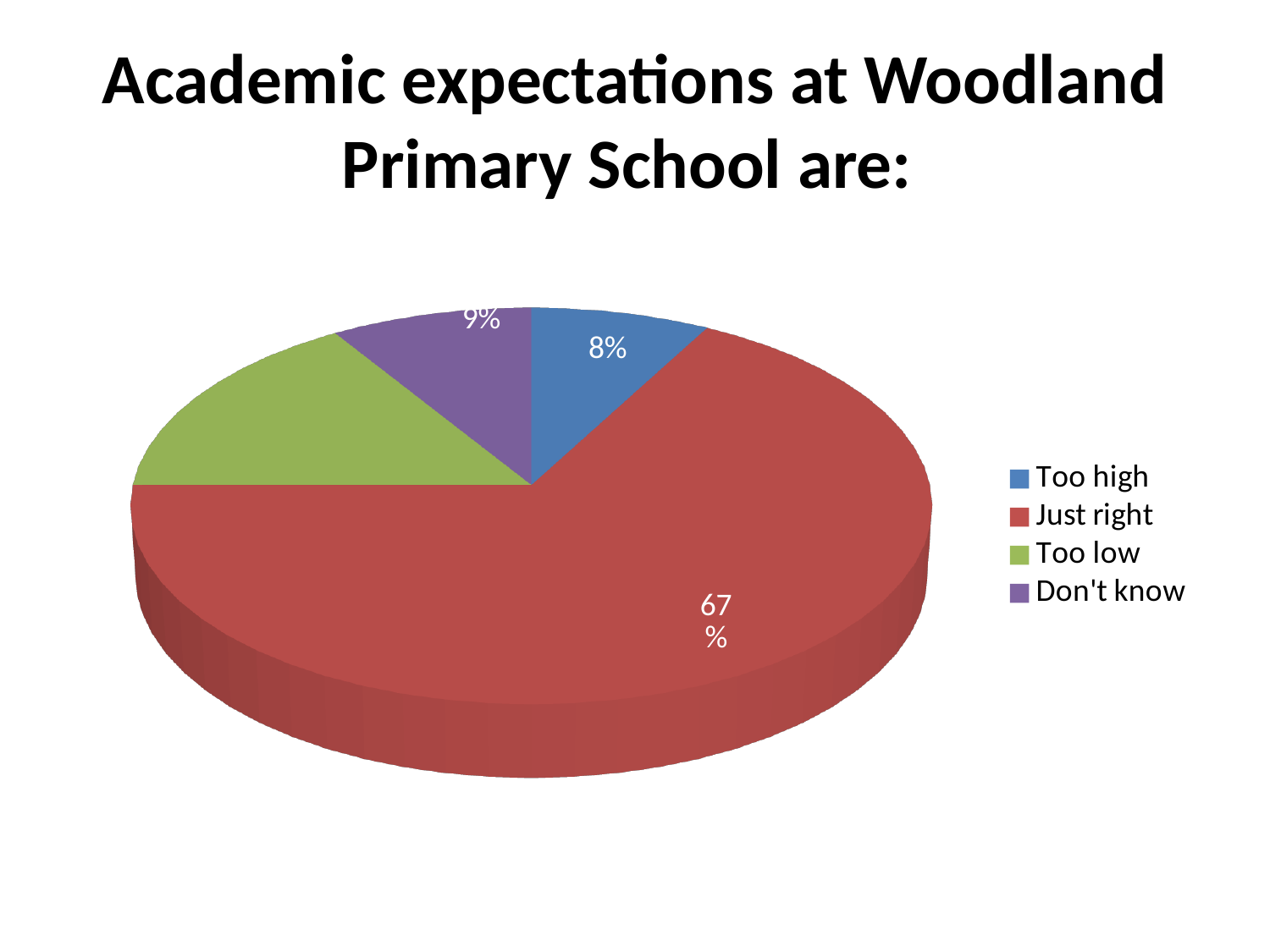
What percentage of the pie is labelled for the 'Just right' slice? 67% Which category has the largest share of the pie? Just right Which category has the smallest share of the pie? Too high What percentage is shown for the 'Too high' slice? 8% Which slice is larger, 'Too low' or 'Don't know'? Too low Which colour represents 'Too low' in the legend? Green What kind of chart is shown on the slide? Pie chart What is the difference in percentage points between the 'Don't know' and 'Too high' slices? 1 What is the difference in percentage points between the 'Just right' and 'Too high' slices? 59 Which slice is larger, 'Just right' or 'Too low'? Just right What percentage is shown for the 'Don't know' slice? 9% How many categories does the pie chart show? 4